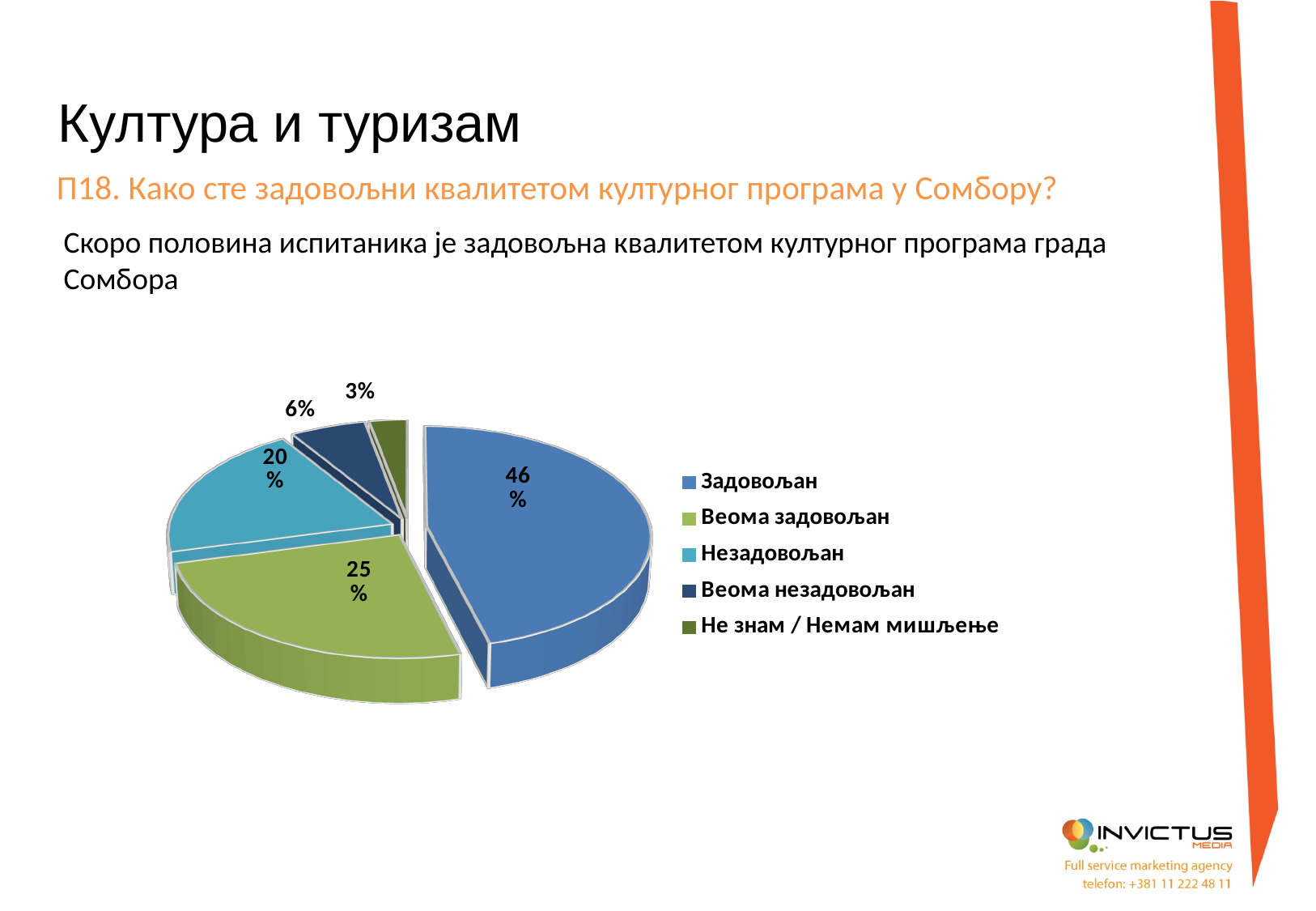
What colour is the slice for "Незадовољан"? light blue What is the difference in percentage points between "Задовољан" and "Веома задовољан"? 21 Which category has the smallest share of the pie? Не знам / Немам мишљење Which category has the largest share of the pie? Задовољан What percentage of respondents answered "Веома незадовољан"? 6% What percentage of respondents answered "Задовољан"? 46% What percentage of respondents answered "Не знам / Немам мишљење"? 3% What percentage of respondents answered "Незадовољан"? 20% What percentage of respondents answered "Веома задовољан"? 25% What kind of chart is shown on the slide? pie chart How many categories does the pie chart show? 5 Which is larger, the share for "Незадовољан" or the share for "Веома незадовољан"? Незадовољан